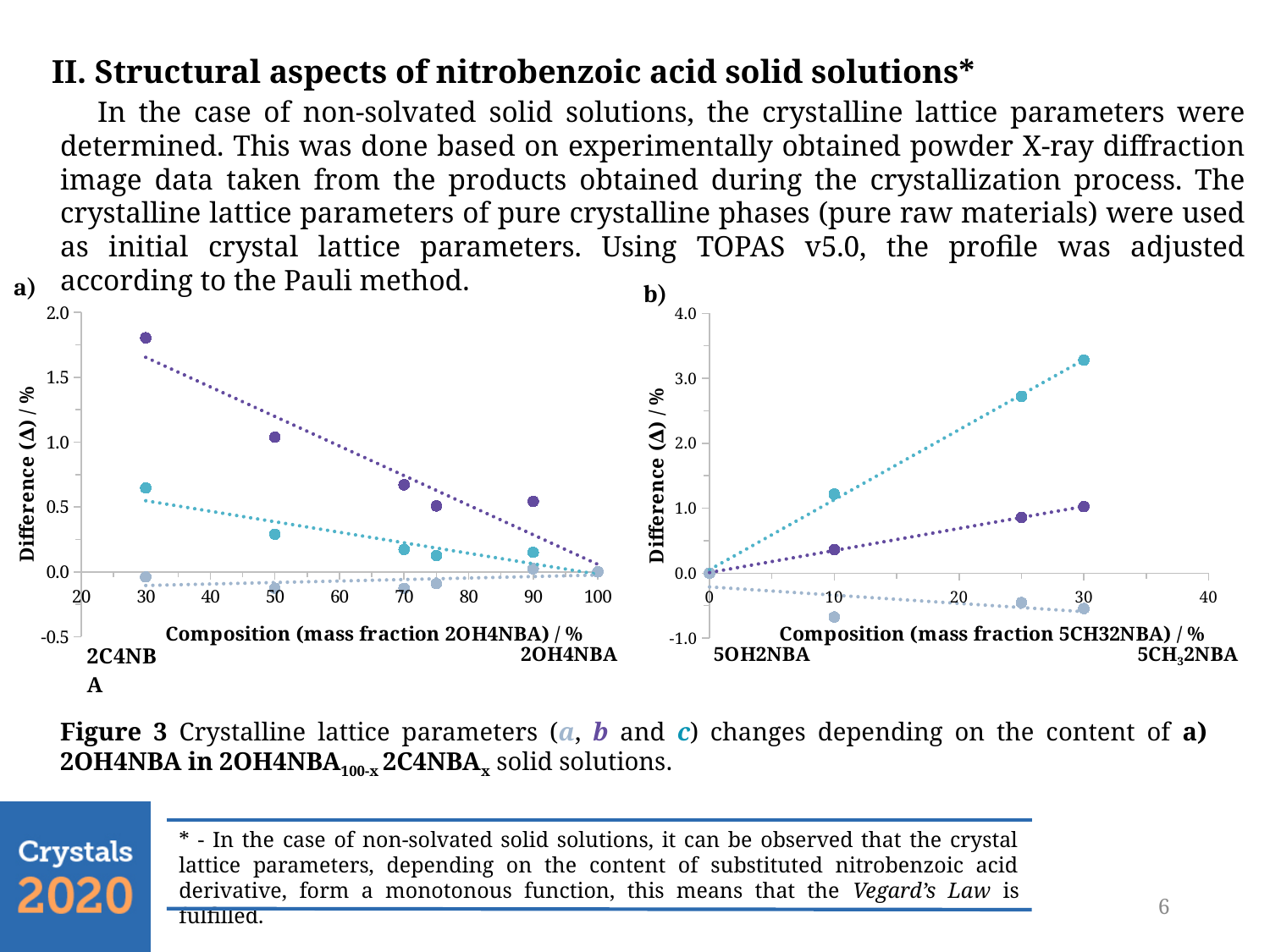
In chart a), is the value of the purple series at composition 30 greater or less than 1.5? greater In chart b), at composition 30, which series has the larger value, the cyan or the purple? cyan In chart a), at composition 30, which series has the larger value, the purple or the cyan? purple In chart b), do the values of the cyan series rise or fall as composition increases? rise What kind of chart is chart a)? scatter chart In chart b), is the value of the cyan series at composition 25 greater or less than 2.0? greater In chart a), is the value of the cyan series at composition 30 greater or less than 0.5? greater What is the y-axis title of chart a)? Difference (Δ) / % In chart a), at which composition does the purple series reach its highest value? 30 What is the x-axis title of chart b)? Composition (mass fraction 5CH32NBA) / % In chart a), do the values of the purple series rise or fall as composition increases? fall